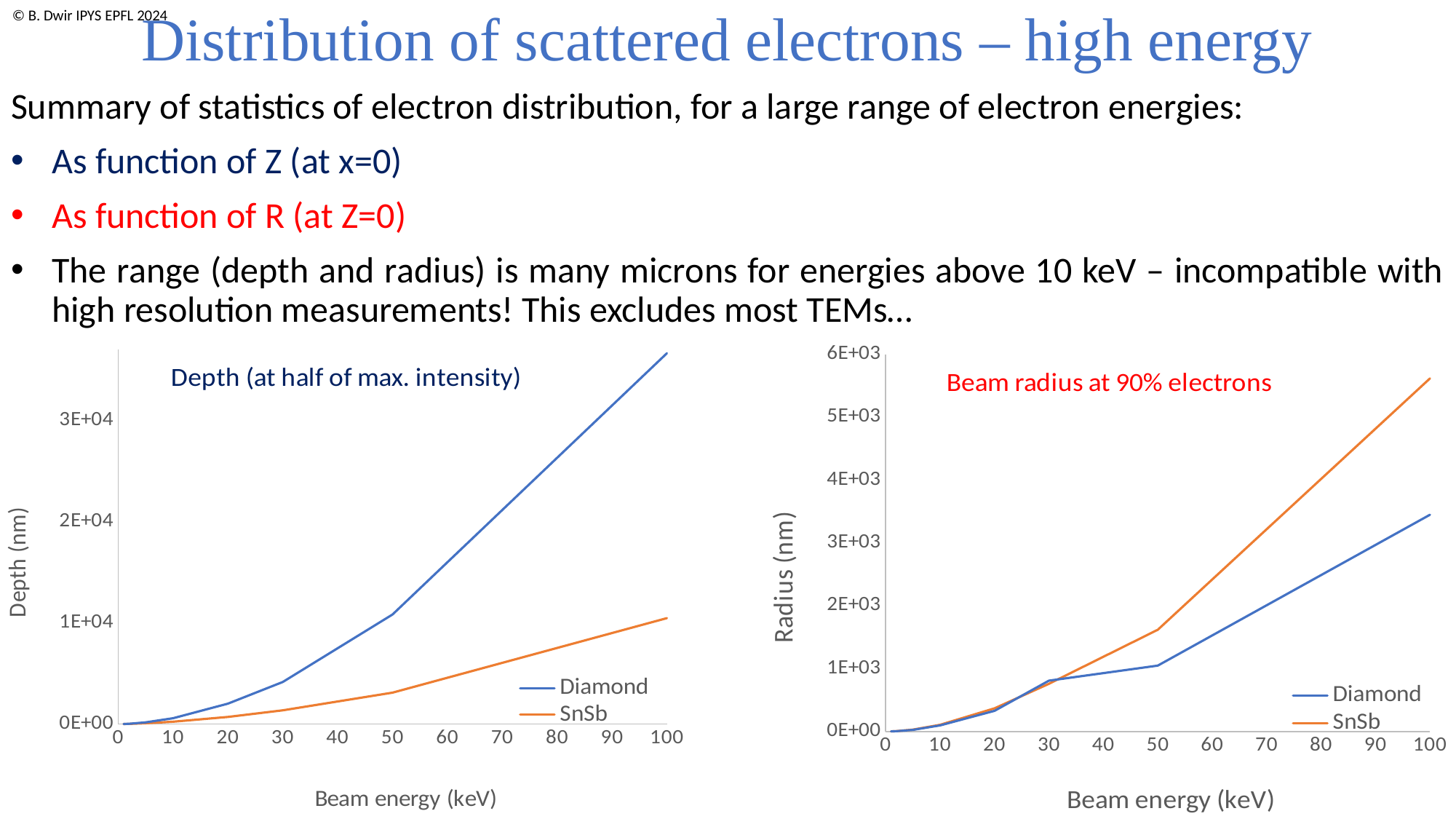
In the 'Beam radius at 90% electrons' chart, which series has the larger value at 100 keV, Diamond or SnSb? SnSb In the 'Beam radius at 90% electrons' chart, is the SnSb value at 50 keV greater or less than 1E+03? greater In the 'Beam radius at 90% electrons' chart, does the Diamond series rise or fall as beam energy increases? rise In the 'Depth (at half of max. intensity)' chart, is the Diamond value at 100 keV greater or less than 3E+04? greater In the 'Depth (at half of max. intensity)' chart, which series has the larger value at 100 keV, Diamond or SnSb? Diamond What is the x-axis label of the 'Depth (at half of max. intensity)' chart? Beam energy (keV) What is the y-axis label of the 'Beam radius at 90% electrons' chart? Radius (nm) In the 'Depth (at half of max. intensity)' chart, is the Diamond value at 30 keV greater or less than 1E+04? less How many series does the legend of the 'Beam radius at 90% electrons' chart list? 2 What type of chart is the left chart titled 'Depth (at half of max. intensity)'? line chart